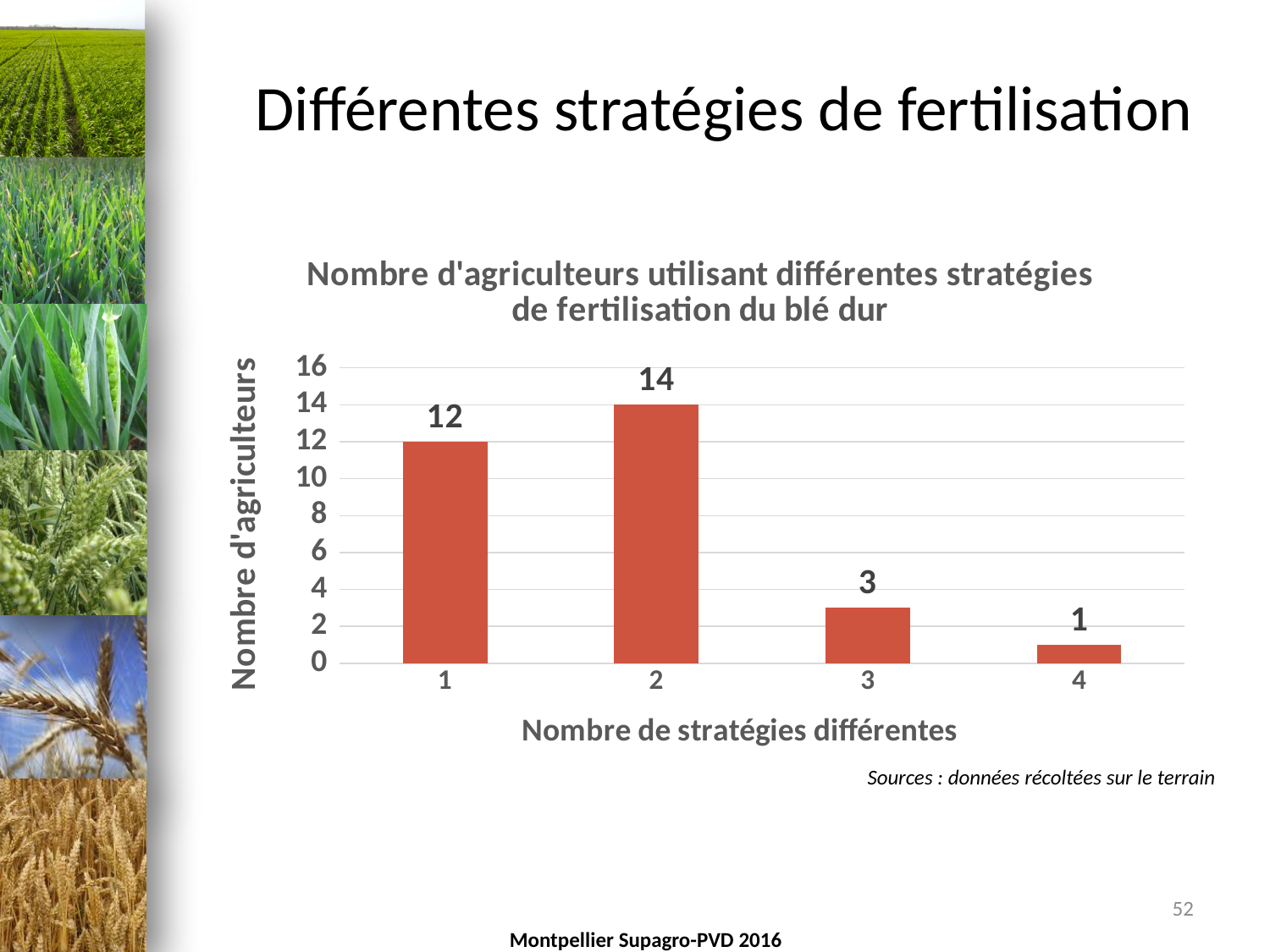
What is the number of farmers for category 1 (one strategy)? 12 What is the difference between the number of farmers using 3 strategies and those using 4 strategies? 2 What kind of chart is shown on the slide? Bar chart How many farmers use 2 different fertilisation strategies? 14 How many farmers use 4 different strategies? 1 Which is larger: the number of farmers using 1 strategy or the number using 3 strategies? 1 strategy What is the total number of farmers across all four categories? 30 What is the title of the chart? Nombre d'agriculteurs utilisant différentes stratégies de fertilisation du blé dur Which number of strategies has the highest number of farmers? 2 What is the difference between the number of farmers using 2 strategies and those using 1 strategy? 2 Which number of strategies has the lowest number of farmers? 4 How many categories are shown on the x axis? 4